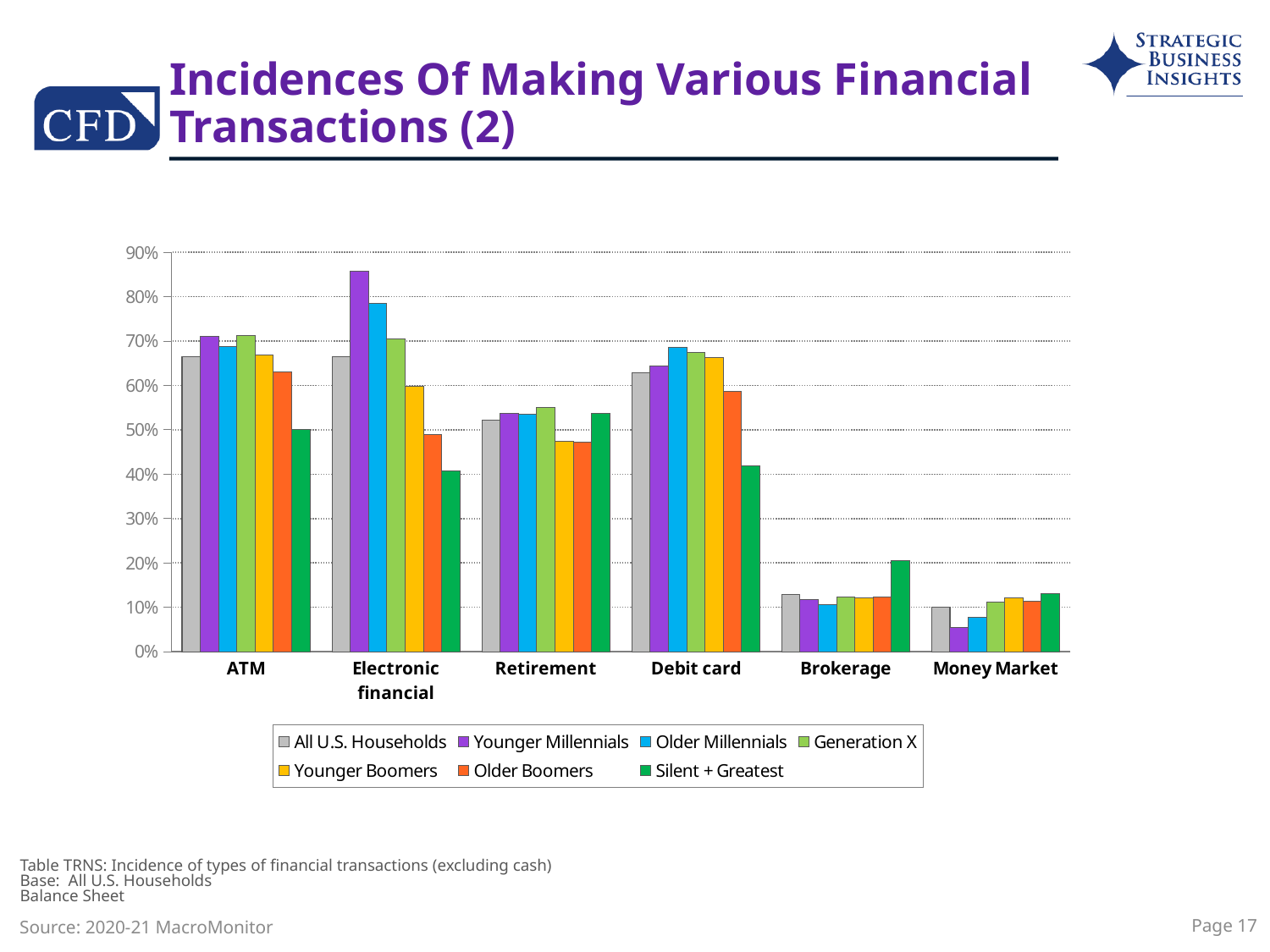
For Brokerage, which is larger: Silent + Greatest or All U.S. Households? Silent + Greatest For Money Market, which series has the lowest value? Younger Millennials Is the value for Silent + Greatest in Debit card greater or less than 50%? less How many series does the legend list? 7 Is the value for Younger Millennials in Electronic financial greater or less than 80%? greater What kind of chart is shown on the slide? bar chart For Electronic financial, which series has the highest value? Younger Millennials For Brokerage, which series has the highest value? Silent + Greatest What is the title of the chart on the slide? Incidences Of Making Various Financial Transactions (2) How many transaction categories are shown on the x axis? 6 Is the value for Silent + Greatest in ATM greater or less than 60%? less For Electronic financial, which series has the lowest value? Silent + Greatest